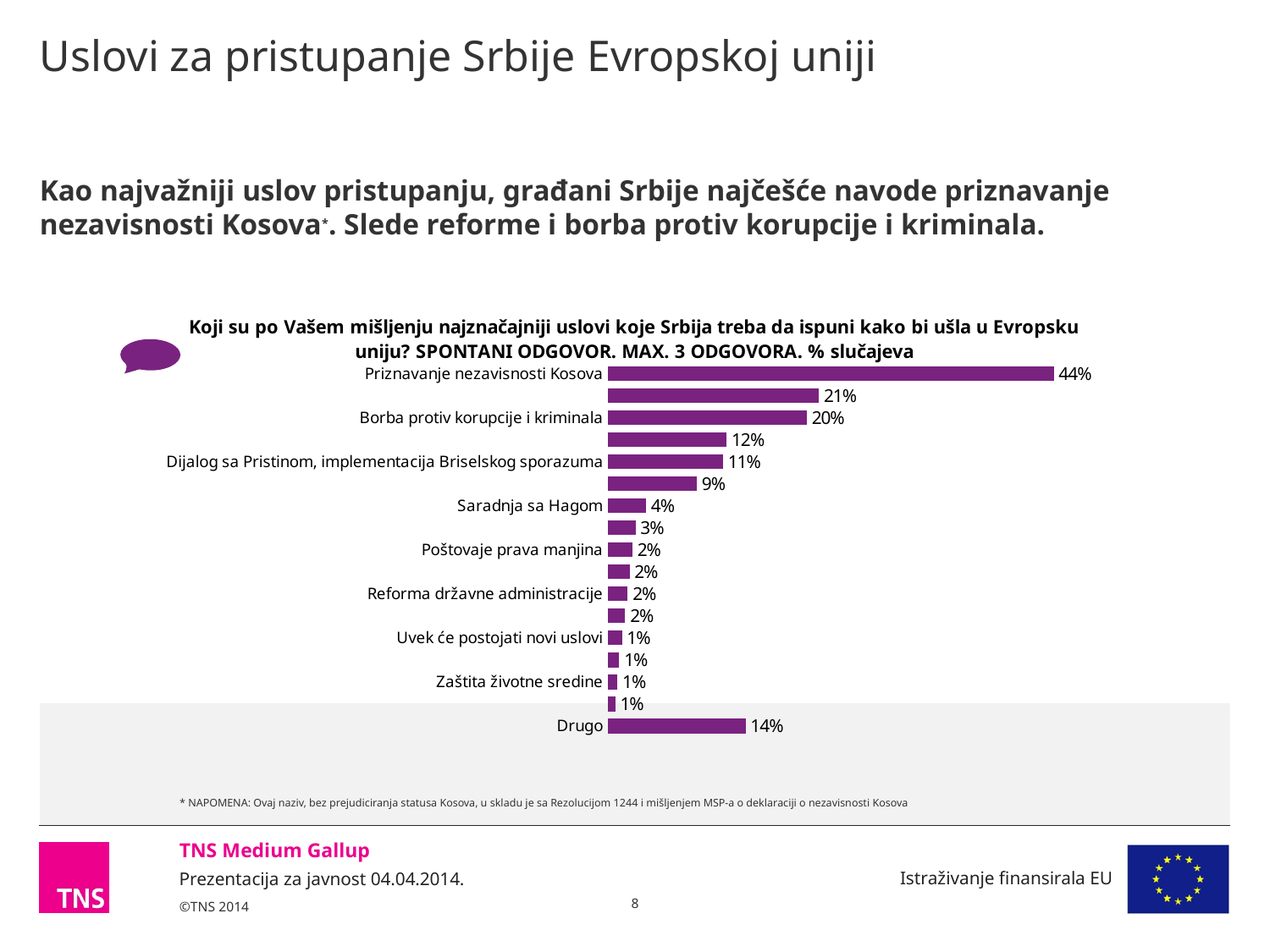
Which category has the highest value? Priznavanje nezavisnosti Kosova What is the difference between the values for "Priznavanje nezavisnosti Kosova" and "Borba protiv korupcije i kriminala"? 24 percentage points What kind of chart is shown on the slide? Bar chart What is the value for "Saradnja sa Hagom"? 4% What is the value for "Drugo"? 14% What is the value for "Priznavanje nezavisnosti Kosova"? 44% What is the value for "Borba protiv korupcije i kriminala"? 20% Which is larger, the value for "Drugo" or the value for "Dijalog sa Pristinom, implementacija Briselskog sporazuma"? Drugo What is the difference between the values for "Borba protiv korupcije i kriminala" and "Drugo"? 6 percentage points What is the value for "Zaštita životne sredine"? 1% How many bars are plotted in the chart? 17 What is the value for "Dijalog sa Pristinom, implementacija Briselskog sporazuma"? 11%